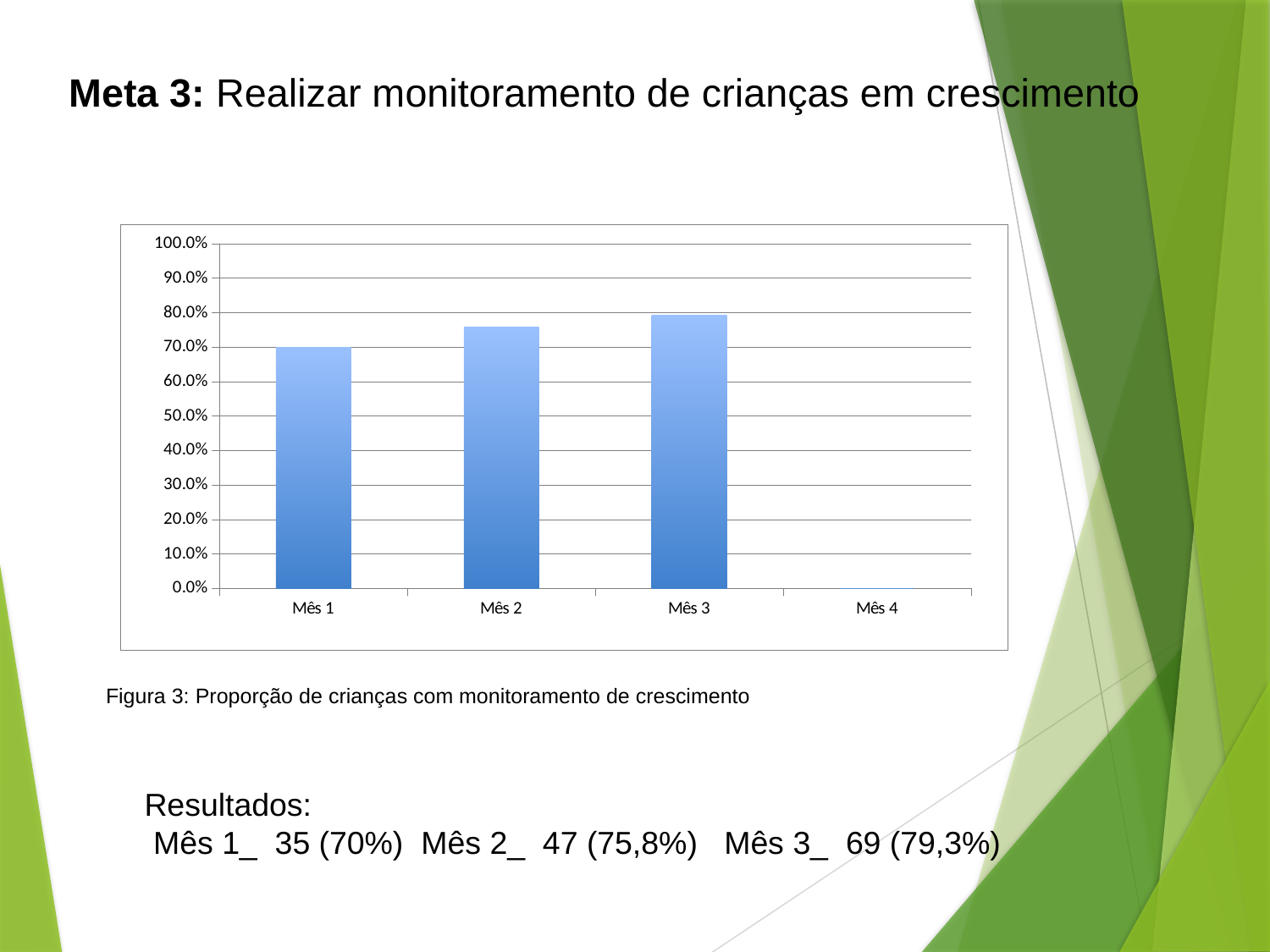
According to the results text on the slide, what is the proportion for Mês 2? 75,8% What kind of chart is shown on the slide? bar chart Which month has the highest bar in the chart? Mês 3 What is the caption given for the chart (Figura 3)? Proporção de crianças com monitoramento de crescimento Is the value for Mês 2 greater or less than 70.0%? greater Is the value for Mês 3 greater or less than 70.0%? greater Do the bar values rise or fall from Mês 1 to Mês 3? rise Is the value for Mês 1 greater or less than 80.0%? less Which month with a plotted bar has the lowest value? Mês 1 How many bars are plotted in the chart? 3 How many categories are shown on the x axis of the chart? 4 Which is larger, the value for Mês 1 or the value for Mês 3? Mês 3